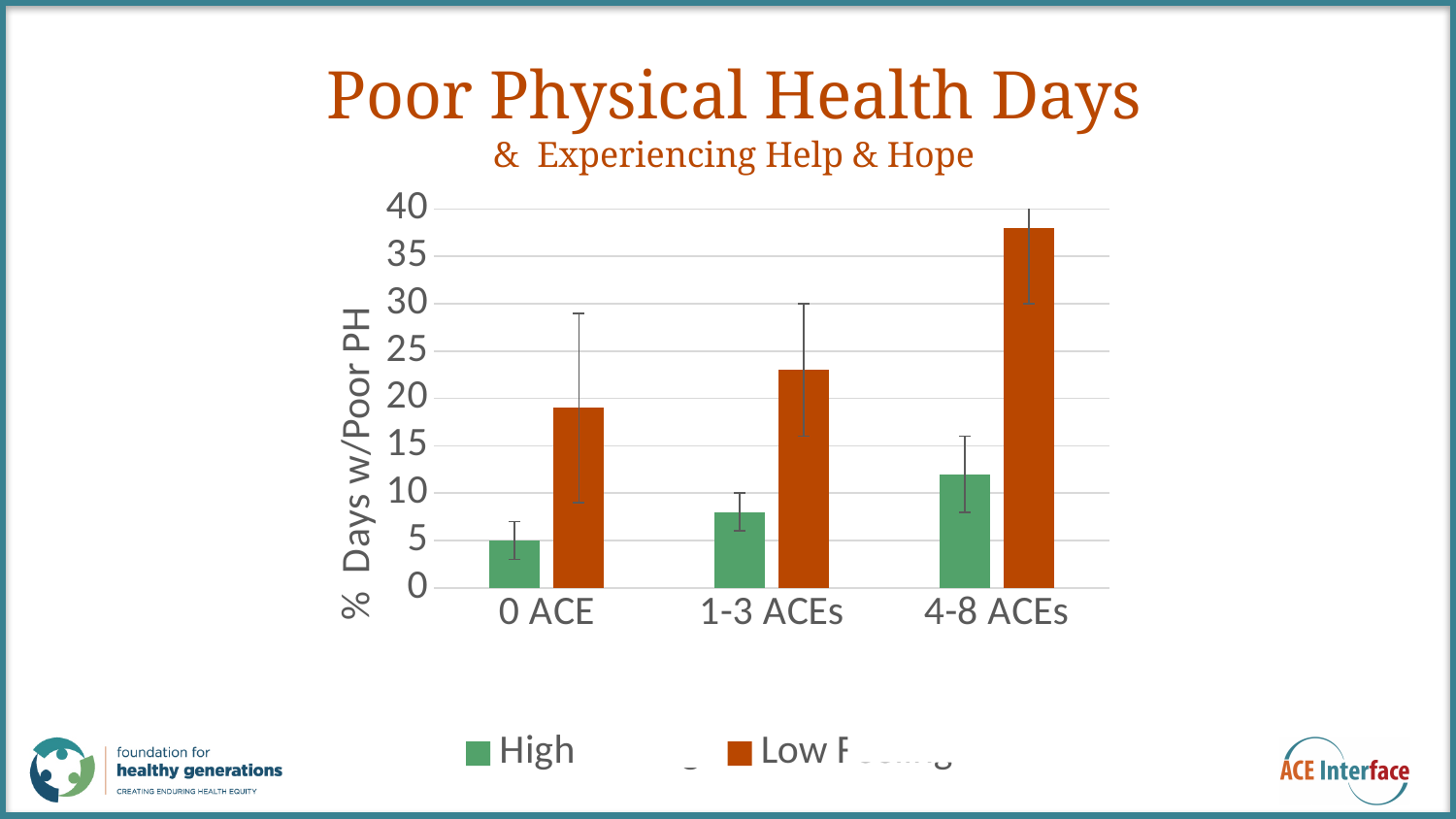
Is the value of the orange (Low) bar for 4-8 ACEs greater or less than 35? greater Which ACE category has the lowest green (High) bar? 0 ACE Is the value of the green (High) bar for 4-8 ACEs greater or less than 10? greater What is the label on the y axis of the chart? % Days w/Poor PH Which ACE category has the highest orange (Low) bar? 4-8 ACEs For the 0 ACE category, which series has the larger value, High or Low? Low Is the value of the green (High) bar for 1-3 ACEs greater or less than 10? less What kind of chart is shown on the slide? bar chart How many series does the legend list? 2 Do the green (High) bars rise or fall as the ACE categories increase along the x axis? rise How many ACE categories are shown on the x axis? 3